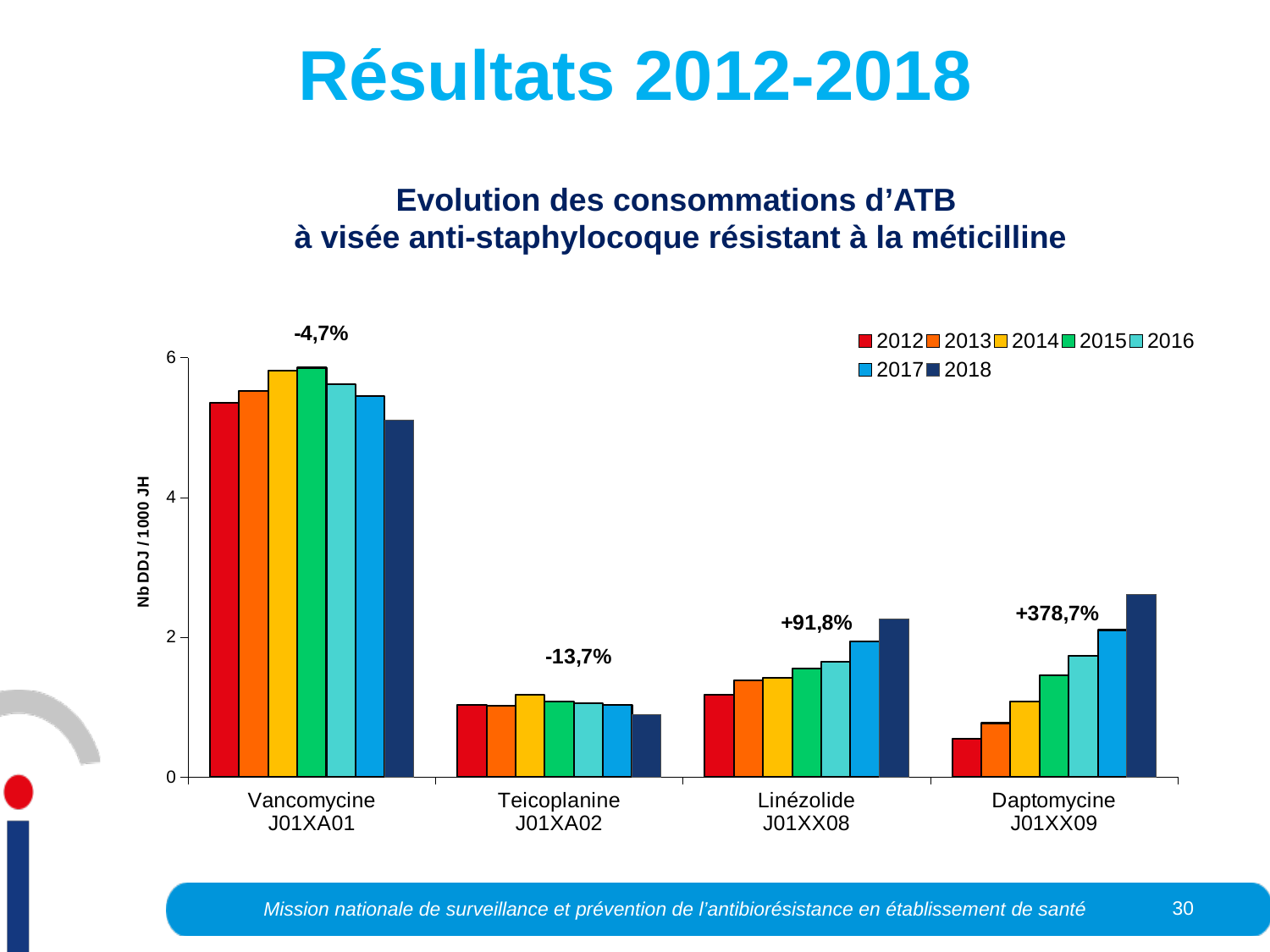
How many series does the legend list? 7 What percentage change is printed above the Teicoplanine J01XA02 bars? -13,7% Is the 2018 value for Teicoplanine J01XA02 greater or less than 2? less What percentage change is printed above the Linézolide J01XX08 bars? +91,8% Is the 2012 value for Vancomycine J01XA01 greater or less than 4? greater Which antibiotic has the highest consumption values in the chart? Vancomycine J01XA01 How many antibiotic categories are shown on the x axis? 4 Do the Daptomycine J01XX09 bars rise or fall from 2012 to 2018? rise What percentage change is printed above the Daptomycine J01XX09 bars? +378,7% What is the label on the y axis? Nb DDJ / 1000 JH What kind of chart is shown on the slide? bar chart What percentage change is printed above the Vancomycine J01XA01 bars? -4,7%